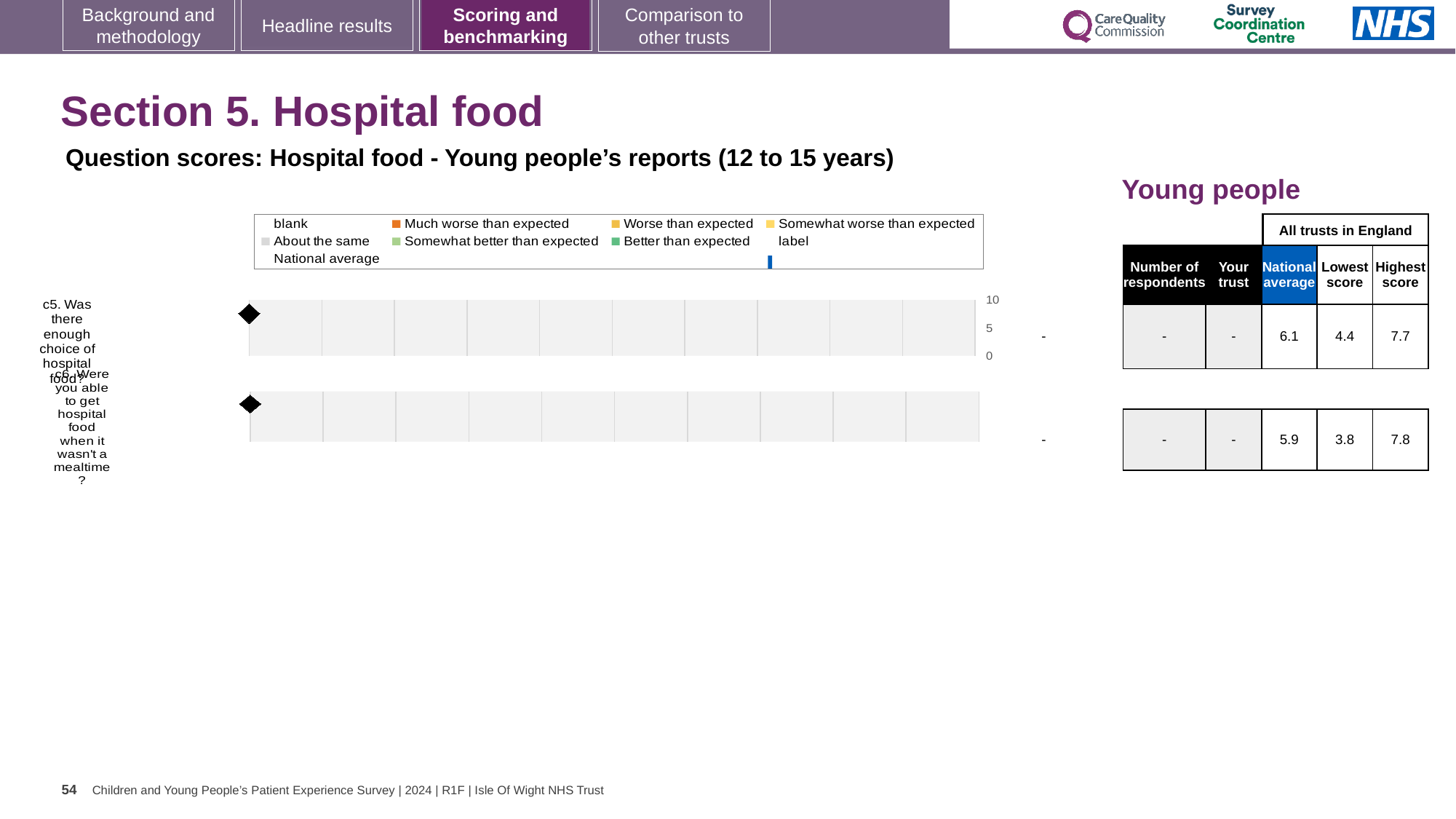
What is the national average score for c6 'Were you able to get hospital food when it wasn't a mealtime?'? 5.9 What is the highest score across all trusts in England for c6? 7.8 How many question categories are plotted on the chart? 2 What is the lowest score across all trusts in England for c5? 4.4 What is the difference between the highest and lowest scores for c5? 3.3 What colour is the 'Much worse than expected' legend entry? orange What is the national average score for c5 'Was there enough choice of hospital food?'? 6.1 What is the highest value shown on the chart's score axis? 10 Which question has the higher national average, c5 or c6? c5 What is shown as the 'Your trust' score for c5? - What kind of chart is shown on the slide? bar chart